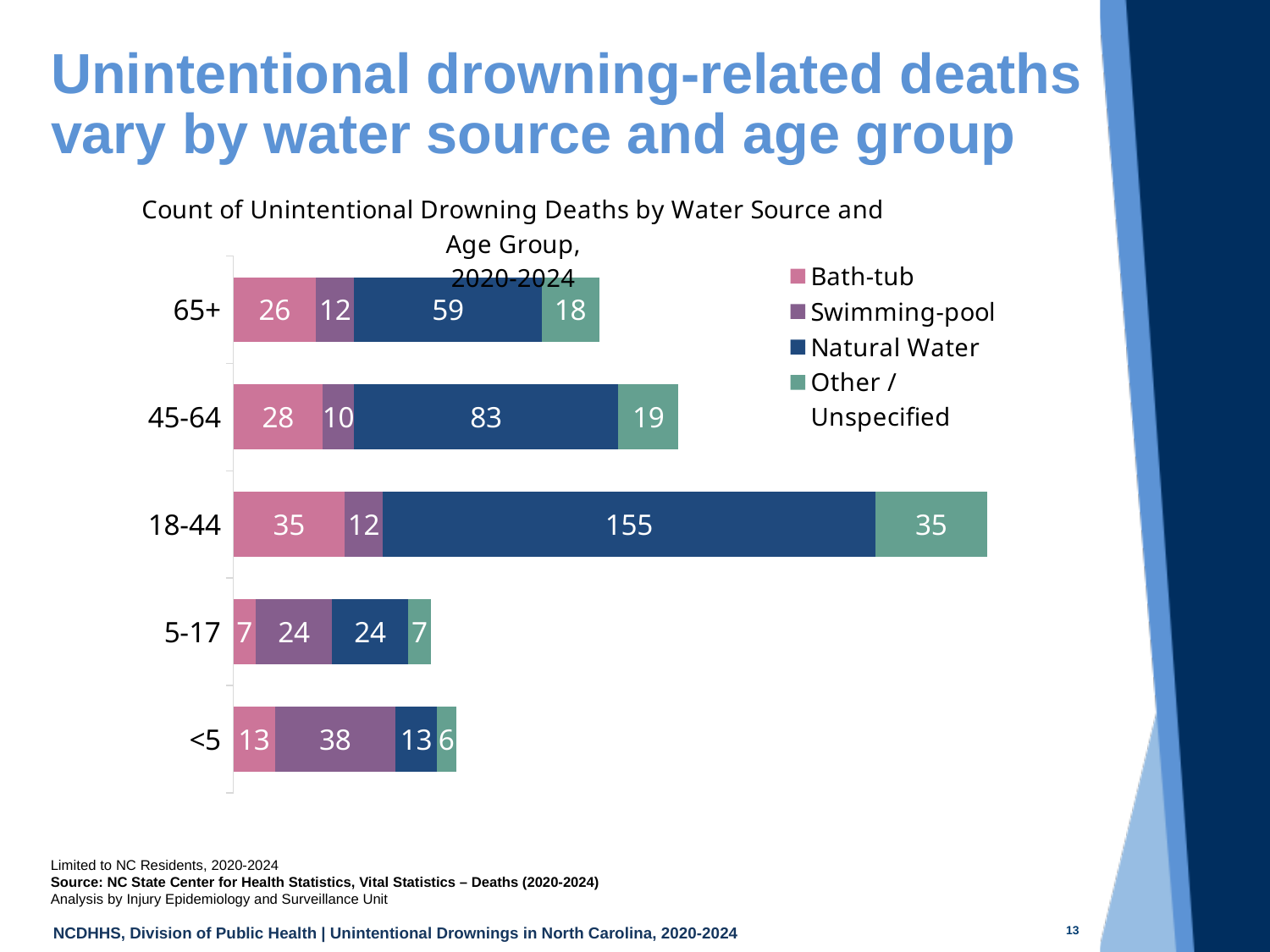
Which age group has the lowest Bath-tub count? 5-17 What is the Swimming-pool count for the <5 age group? 38 What kind of chart is shown on the slide? Stacked bar chart What is the Other / Unspecified count for the 65+ age group? 18 What is the total count for the 18-44 age group across all water sources? 237 How many age groups are shown on the chart? 5 What is the difference between the Natural Water counts for the 18-44 and 45-64 age groups? 72 What is the Bath-tub count for the 45-64 age group? 28 What is the Natural Water count for the 18-44 age group? 155 How many series does the legend list? 4 Which age group has the highest Natural Water count? 18-44 Which is larger: the Swimming-pool count for <5 or for 5-17? <5